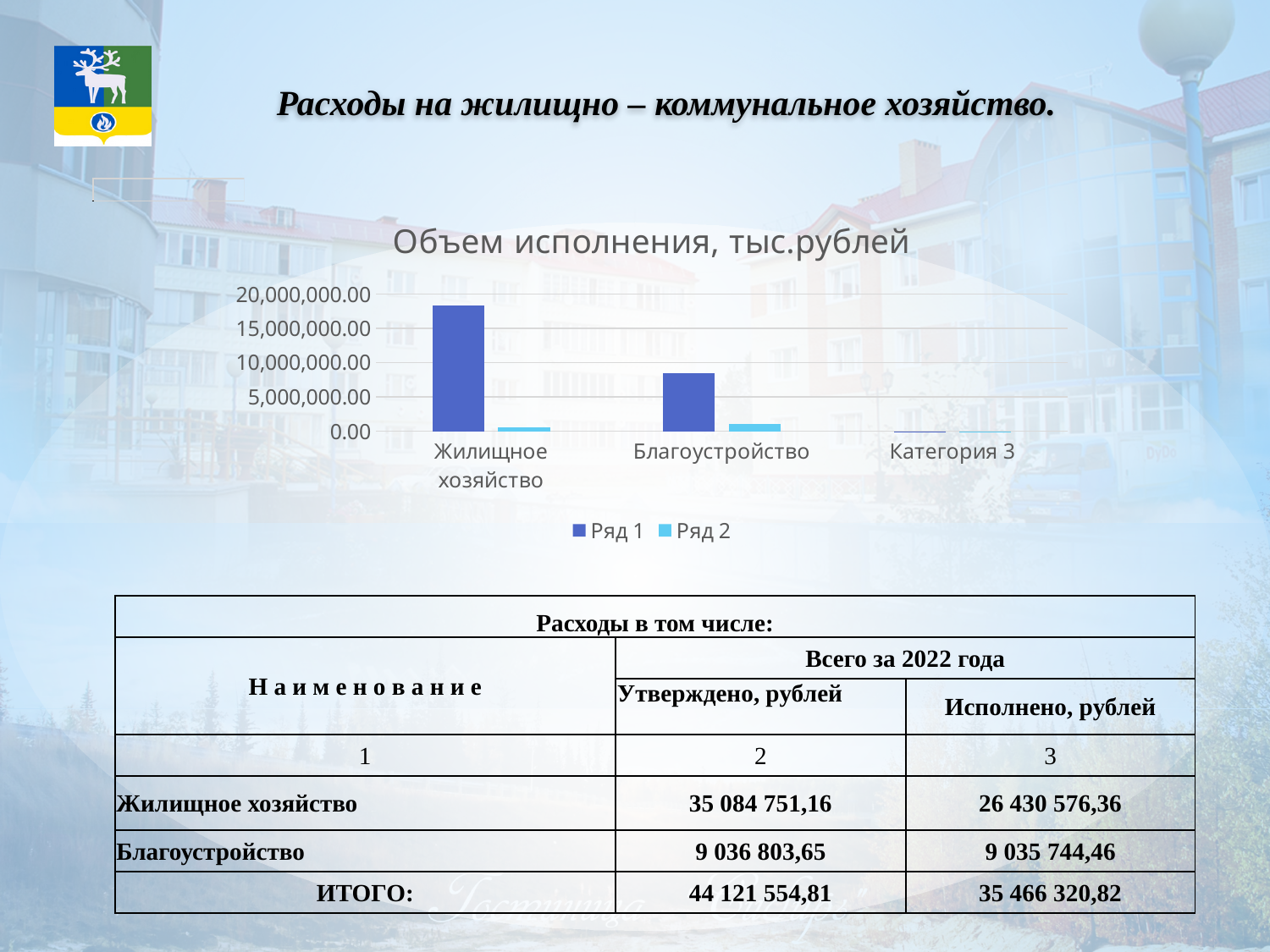
How many series does the chart legend list? 2 Is the Ряд 1 value for Жилищное хозяйство greater or less than 15,000,000.00? greater For Ряд 1, which is larger: Жилищное хозяйство or Благоустройство? Жилищное хозяйство Which category has the highest value for Ряд 1? Жилищное хозяйство Which category has the lowest value for Ряд 1? Категория 3 Is the Ряд 1 value for Благоустройство greater or less than 5,000,000.00? greater What is the title of the chart? Объем исполнения, тыс.рублей Do the Ряд 1 values rise or fall from left to right along the x axis? fall Is the Ряд 1 value for Благоустройство greater or less than 10,000,000.00? less What kind of chart is shown on the slide? bar chart How many categories are shown on the x axis of the chart? 3 For Благоустройство, which series has the larger value: Ряд 1 or Ряд 2? Ряд 1